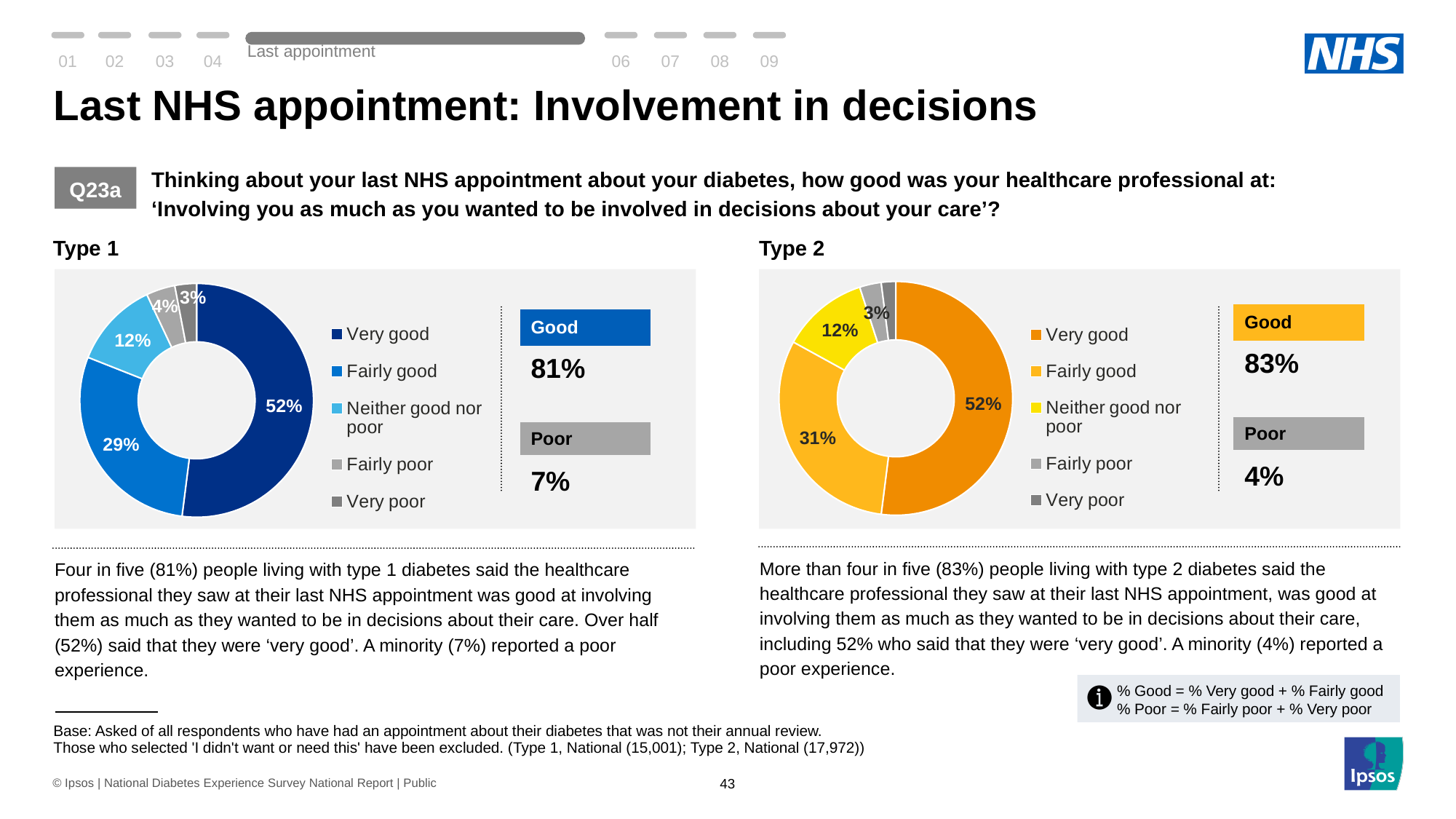
How many response categories does the legend of the Type 2 chart list? 5 What kind of chart is used on the Type 1 side of the slide? Pie (donut) chart In the Type 2 chart, what percentage of respondents said 'Very good'? 52% What is the combined 'Good' percentage shown next to the Type 2 chart? 83% What is the combined 'Poor' percentage shown next to the Type 1 chart? 7% In the Type 1 chart, what is the difference between the 'Very good' and 'Fairly good' shares? 23 percentage points In the Type 1 chart, what percentage of respondents said 'Fairly good'? 29% In the Type 1 chart, what percentage of respondents said 'Very good'? 52% In the Type 2 chart, what percentage of respondents said 'Fairly good'? 31% Which is larger: the 'Fairly good' share in the Type 1 chart or in the Type 2 chart? Type 2 In the Type 1 chart, which response category has the largest share? Very good In the Type 1 chart, what percentage of respondents said 'Neither good nor poor'? 12%